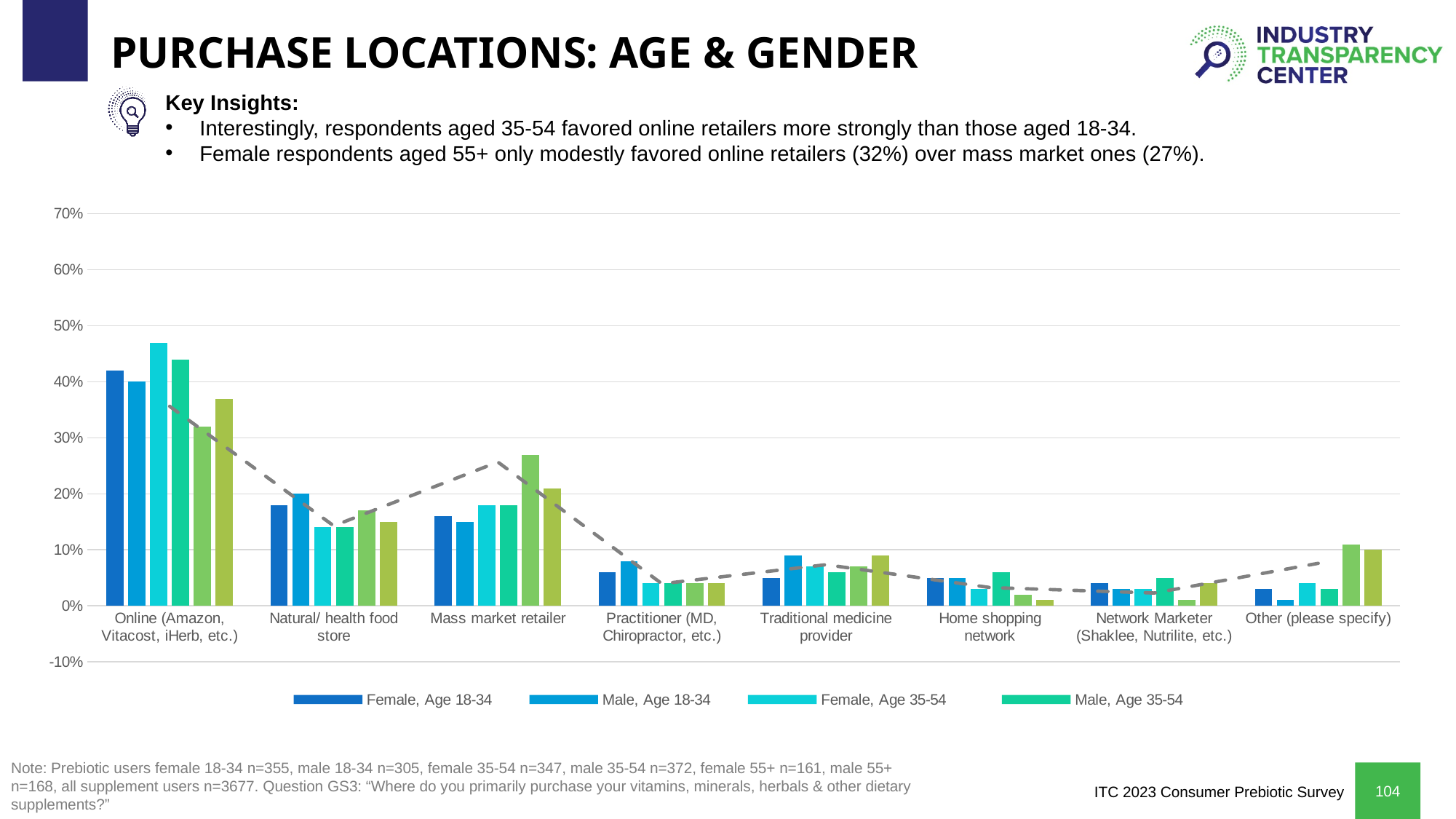
How many purchase location categories are shown on the x axis? 8 What is the title of the slide containing the chart? PURCHASE LOCATIONS: AGE & GENDER Is the value for Female, Age 35-54 at Online (Amazon, Vitacost, iHerb, etc.) greater or less than 40%? greater At Natural/ health food store, which is larger: Male, Age 18-34 or Female, Age 35-54? Male, Age 18-34 How many series does the legend list? 4 What kind of chart is shown on the slide? combination bar and line chart Which purchase location has the highest values across the series? Online (Amazon, Vitacost, iHerb, etc.) Is the value for Female, Age 18-34 at Natural/ health food store greater or less than 20%? less Among the legend series, which has the highest value for Online (Amazon, Vitacost, iHerb, etc.)? Female, Age 35-54 Is the value for Female, Age 18-34 at Practitioner (MD, Chiropractor, etc.) greater or less than 10%? less Among the legend series, which has the lowest value for Online (Amazon, Vitacost, iHerb, etc.)? Male, Age 18-34